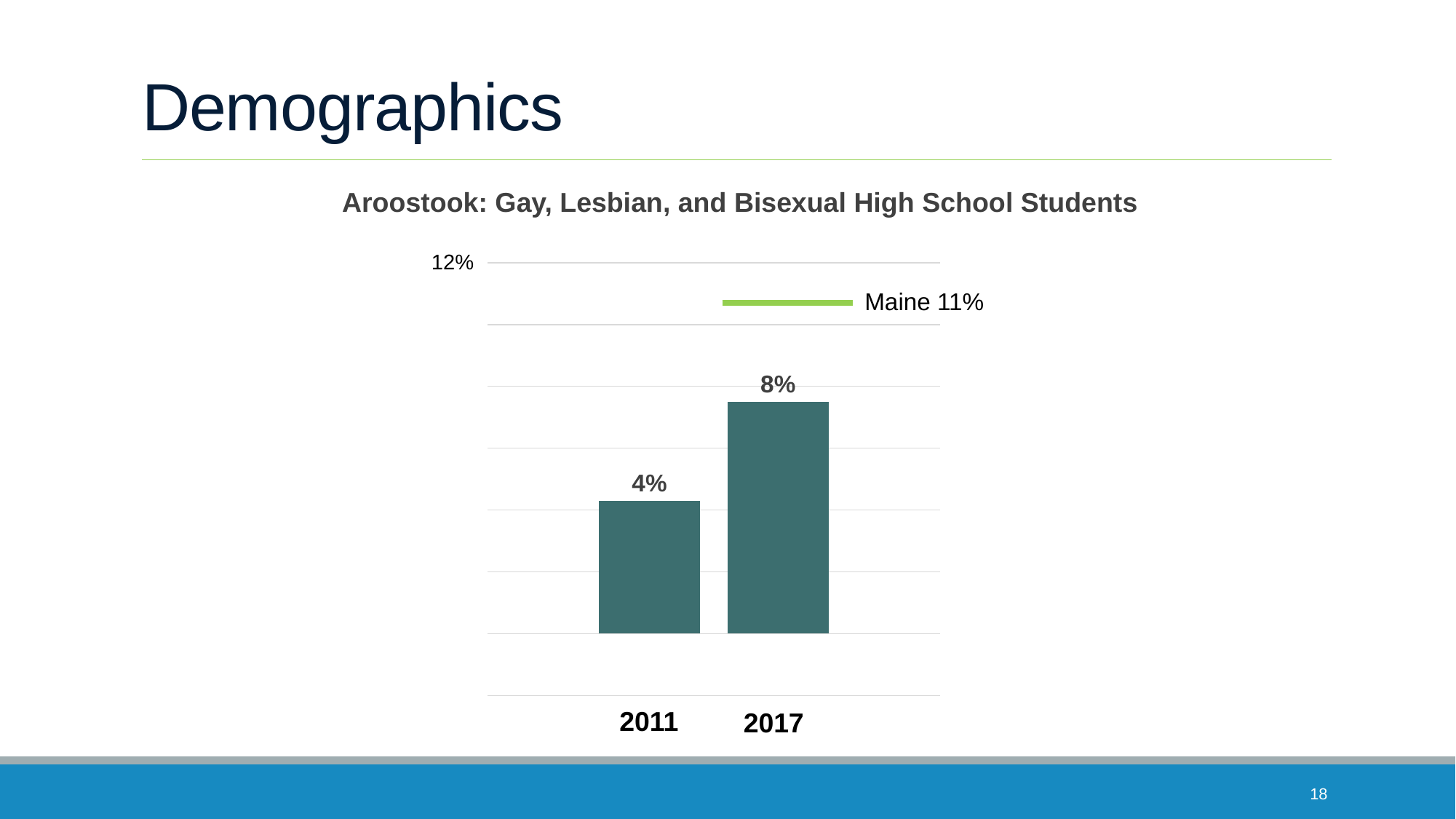
How many years are shown as bars in the chart? 2 What is the highest value labelled on the vertical axis? 12% Do the values rise or fall from 2011 to 2017? rise Which year has the lowest value? 2011 What is the difference between the 2017 and 2011 values? 4% Which year has the highest value? 2017 Which is larger, the value for 2011 or the value for 2017? 2017 What kind of chart is shown on the slide? bar chart What is the title of the chart? Aroostook: Gay, Lesbian, and Bisexual High School Students What is the value for 2017? 8% What is the Maine reference value shown on the chart? 11% What is the value for 2011? 4%